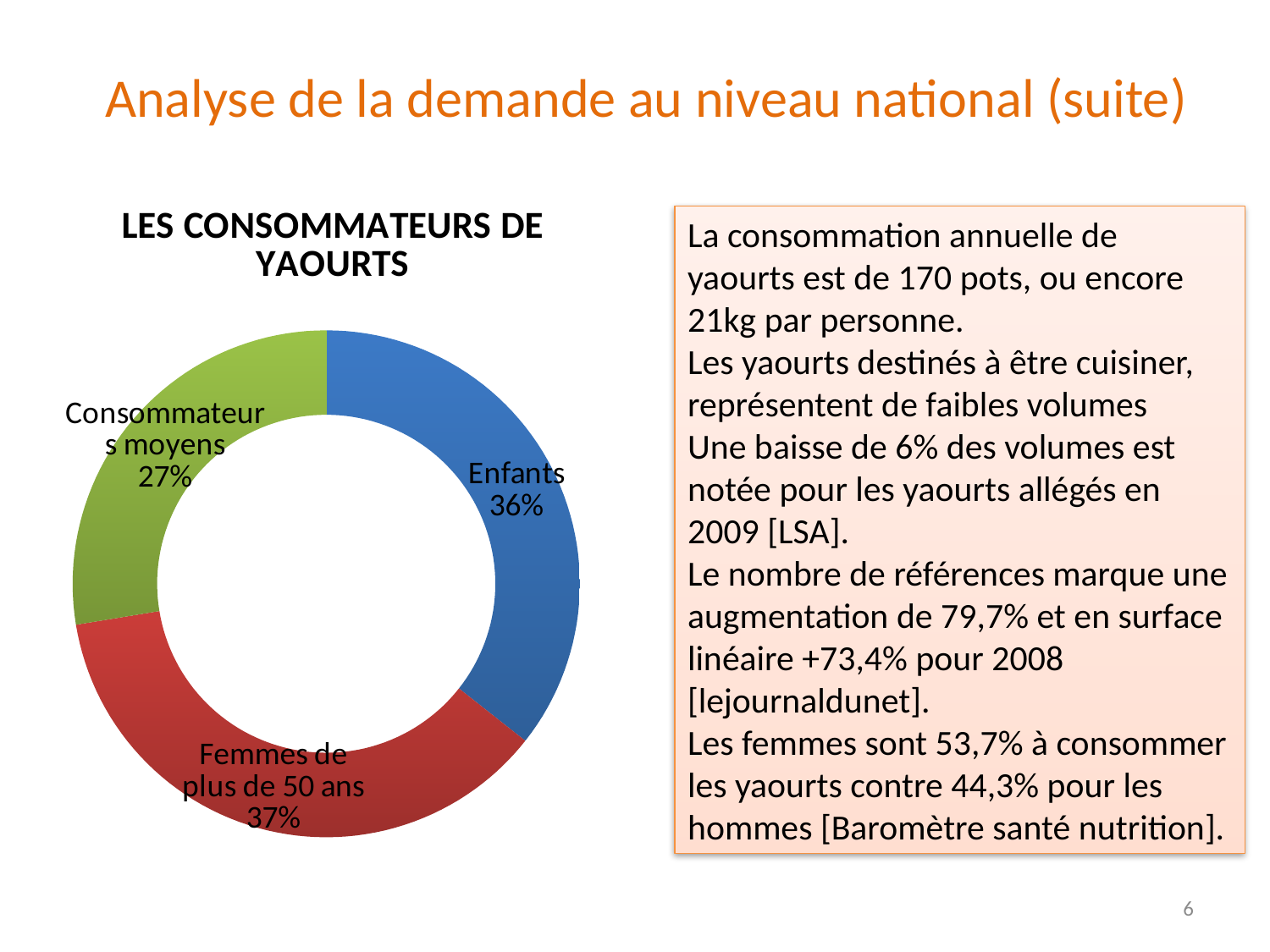
What percentage is shown for Femmes de plus de 50 ans? 37% Which category has the largest share of the chart? Femmes de plus de 50 ans What percentage is shown for Consommateurs moyens? 27% Which category has the smallest share of the chart? Consommateurs moyens What is the title of the chart? LES CONSOMMATEURS DE YAOURTS What kind of chart is shown on the slide? doughnut chart What colour is the Enfants slice? blue What share of yogurt consumers does the Enfants slice represent? 36% What is the difference in percentage points between Femmes de plus de 50 ans and Consommateurs moyens? 10 How many categories are shown in the chart? 3 What is the difference in percentage points between Enfants and Consommateurs moyens? 9 Which is larger, the share for Enfants or the share for Consommateurs moyens? Enfants